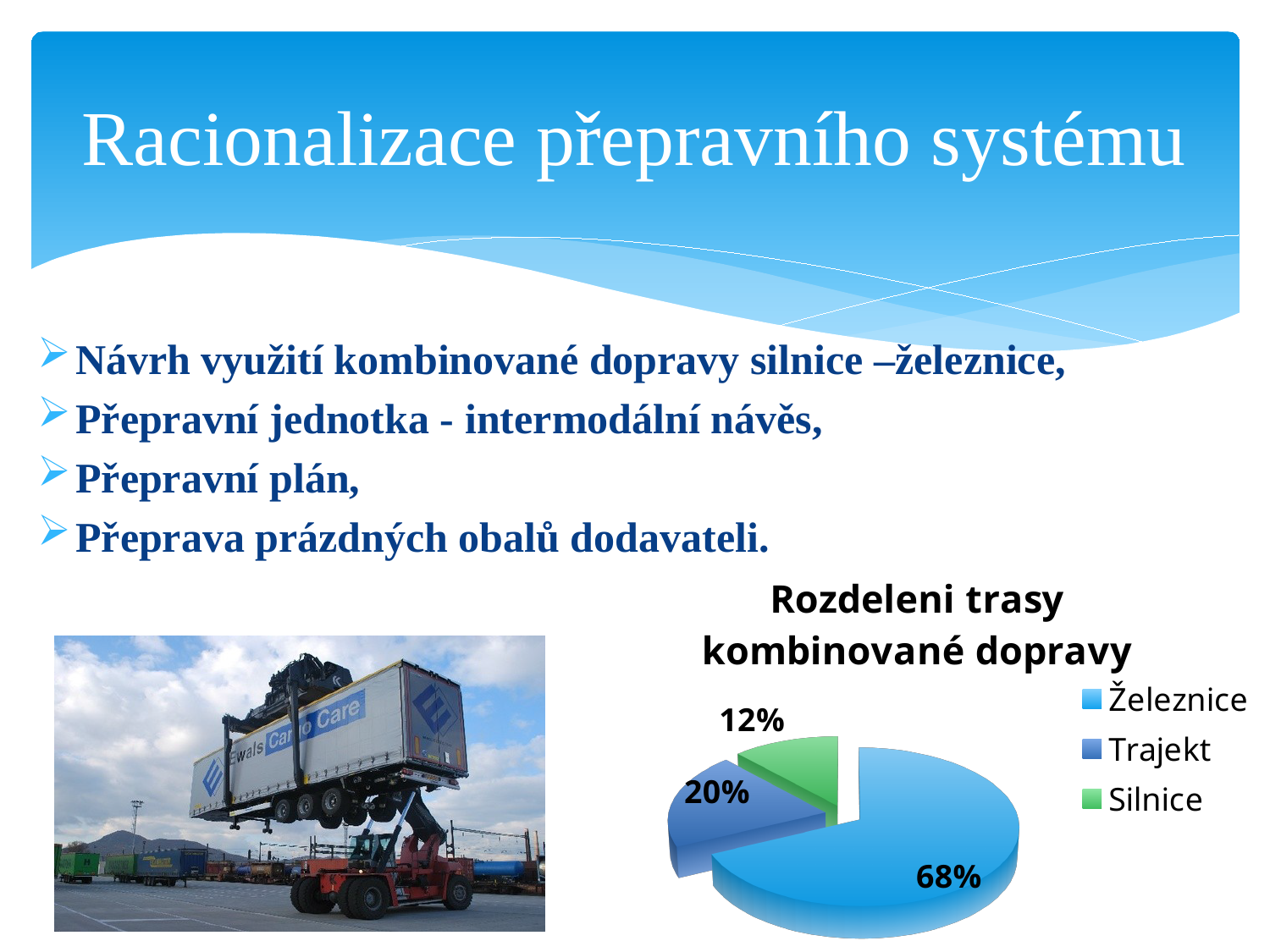
What is the difference in percentage points between Železnice and Trajekt? 48 How many categories does the pie chart show? 3 What share of the pie does Trajekt have? 20% Which colour represents Silnice in the pie chart? green What is the difference in percentage points between Trajekt and Silnice? 8 Which category has the smallest share of the pie? Silnice Which category has the largest share of the pie? Železnice What is the title of the chart? Rozdeleni trasy kombinované dopravy What share of the pie does Železnice have? 68% Which is larger, the share for Trajekt or the share for Silnice? Trajekt What kind of chart is shown on the slide? pie chart What share of the pie does Silnice have? 12%